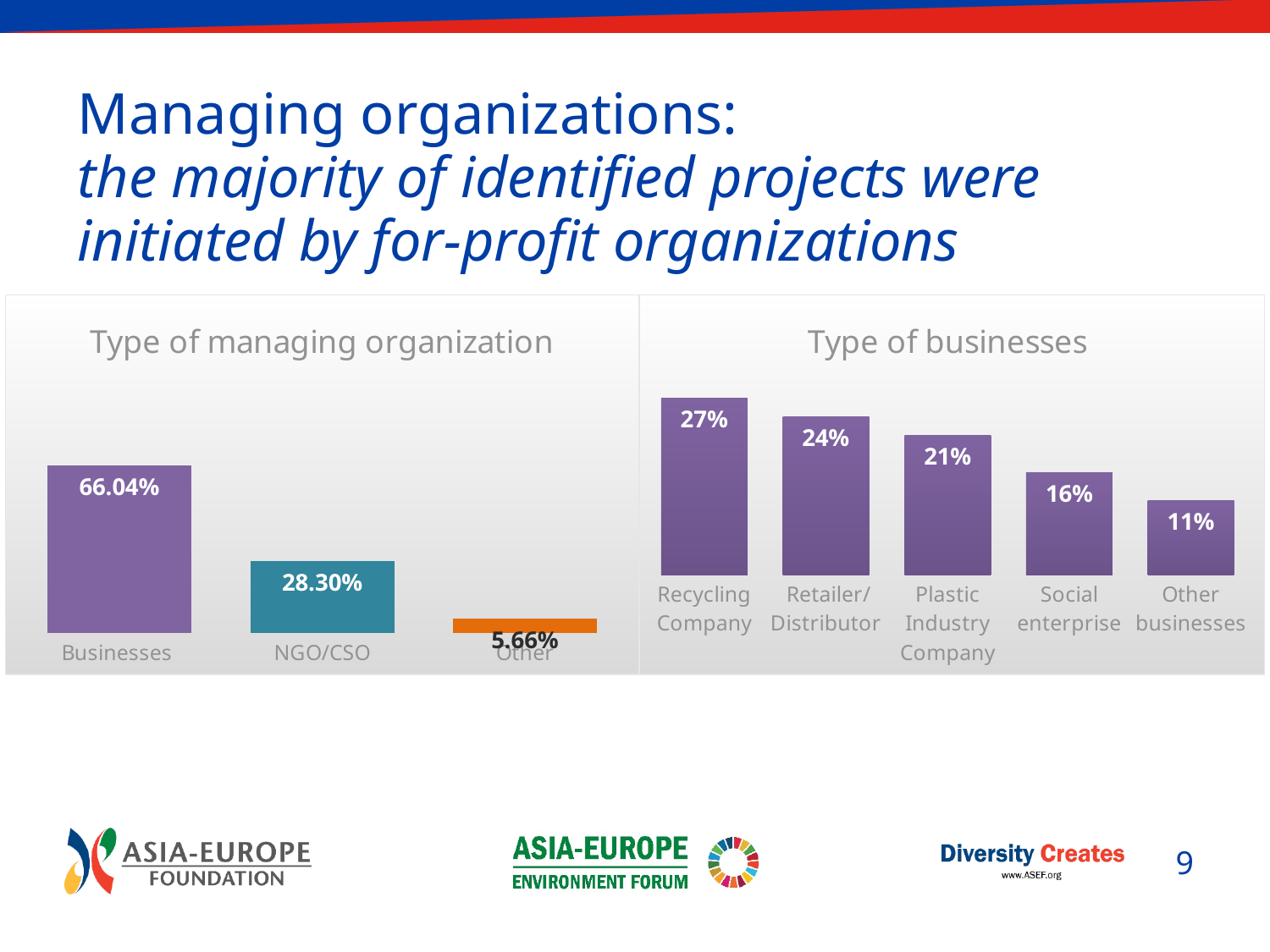
In the 'Type of managing organization' chart, what is the difference between Businesses and NGO/CSO? 37.74% In the 'Type of businesses' chart, which is larger: Plastic Industry Company or Other businesses? Plastic Industry Company In the 'Type of managing organization' chart, what is the value for NGO/CSO? 28.30% What kind of chart is the 'Type of businesses' chart? bar chart In the 'Type of businesses' chart, what is the value for Social enterprise? 16% In the 'Type of managing organization' chart, how many categories are shown? 3 In the 'Type of managing organization' chart, what is the value for Businesses? 66.04% In the 'Type of businesses' chart, what is the value for Retailer/Distributor? 24% In the 'Type of businesses' chart, which category has the highest value? Recycling Company In the 'Type of businesses' chart, do the values rise or fall from left to right? fall In the 'Type of businesses' chart, what is the difference between Recycling Company and Other businesses? 16% In the 'Type of managing organization' chart, which category has the lowest value? Other